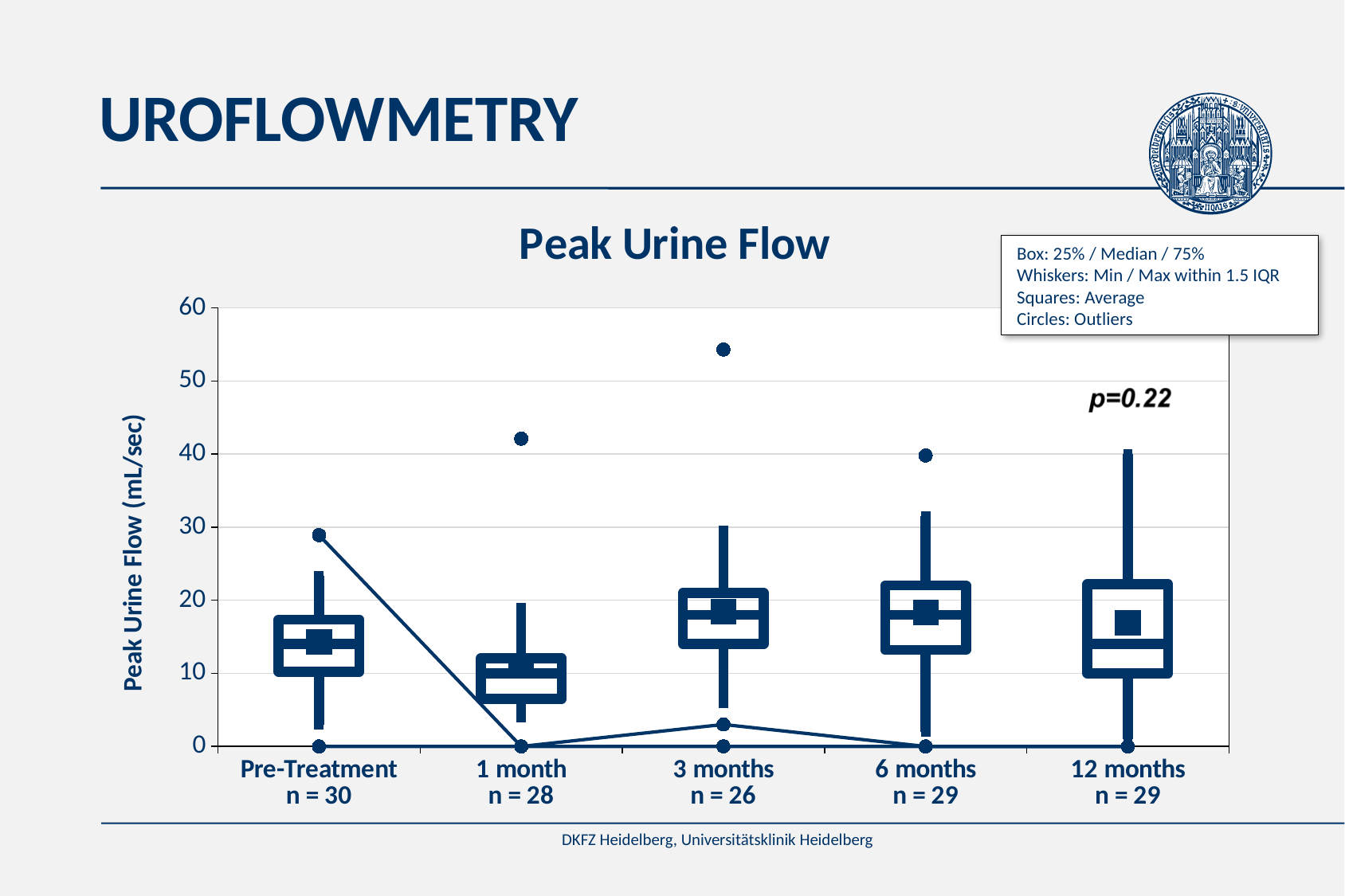
Which time point has the highest outlier value? 3 months Is the median peak urine flow for Pre-Treatment greater or less than 20 mL/sec? less What p-value is printed on the chart? p=0.22 Which time point has the lowest median peak urine flow? 1 month How many time points (categories) are shown on the x axis? 5 What kind of chart is shown on the slide? box plot Is the highest outlier at 3 months greater or less than 50 mL/sec? greater What is the title of the chart? Peak Urine Flow What is the sample size (n) for the 1 month group? n = 28 What is the sample size (n) for the Pre-Treatment group? n = 30 What is the sample size (n) for the 3 months group? n = 26 Which is larger, the median peak urine flow at 3 months or at 1 month? 3 months